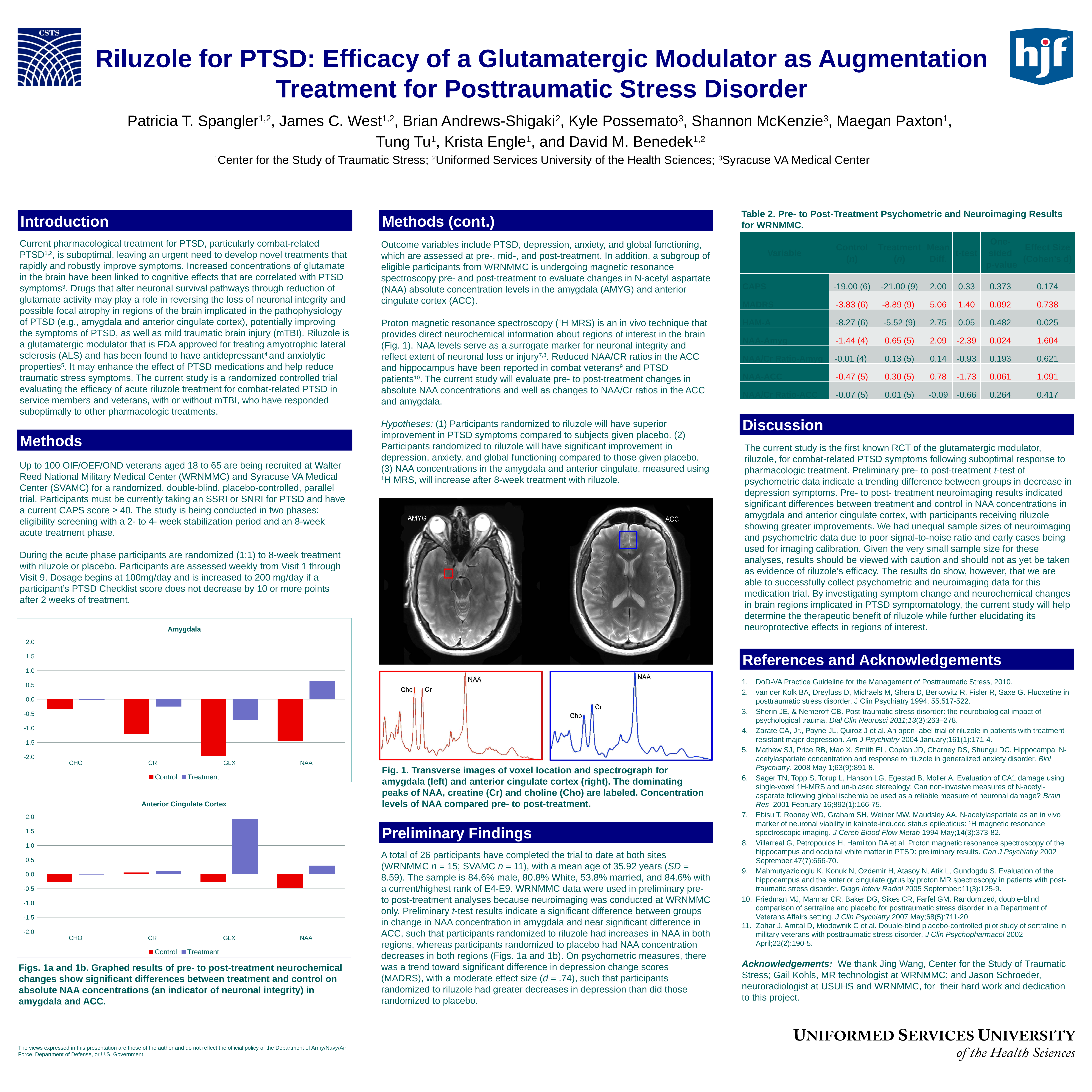
In the Anterior Cingulate Cortex chart, which category has the highest Treatment value? GLX In the Anterior Cingulate Cortex chart, is the Treatment value for GLX greater or less than 1.5? greater In the Amygdala chart, what colour represents the Control series? red What kind of chart is the Amygdala chart? bar chart In the Amygdala chart, which category has the lowest Control value? GLX In the Amygdala chart, is the Control value for CR greater or less than -1.0? less In the Amygdala chart, is the Control value for GLX greater or less than -1.5? less In the Anterior Cingulate Cortex chart, which is larger for GLX: the Control value or the Treatment value? Treatment How many categories are shown on the x axis of the Anterior Cingulate Cortex chart? 4 In the Amygdala chart, which is larger for NAA: the Control value or the Treatment value? Treatment How many series does the legend of the Amygdala chart list? 2 In the Amygdala chart, which category has the highest Treatment value? NAA